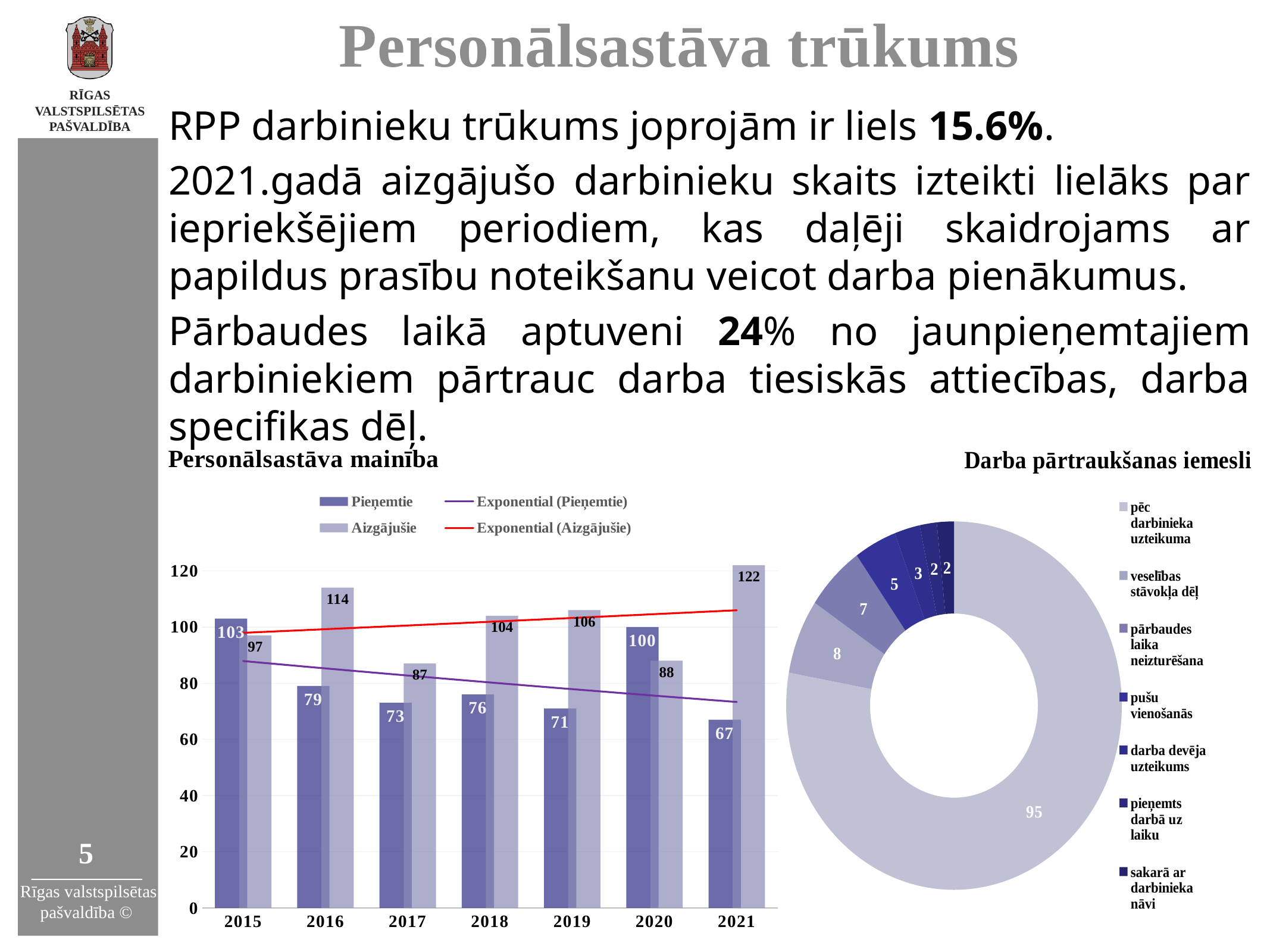
In the 'Personālsastāva mainība' chart, do the Pieņemtie values overall rise or fall from 2015 to 2021? Fall In the 'Personālsastāva mainība' chart, what is the Pieņemtie value for 2015? 103 In the 'Personālsastāva mainība' chart, which year has the highest Aizgājušie value? 2021 In the 'Personālsastāva mainība' chart, which year has the lowest Pieņemtie value? 2021 In the 'Darba pārtraukšanas iemesli' chart, what is the value for 'pēc darbinieka uzteikuma'? 95 In the 'Darba pārtraukšanas iemesli' chart, how many categories does the legend list? 7 How many years are shown on the x axis of the 'Personālsastāva mainība' chart? 7 In the 'Personālsastāva mainība' chart, what is the Aizgājušie value for 2016? 114 What kind of chart is 'Personālsastāva mainība'? Bar chart In the 'Personālsastāva mainība' chart, what is the difference between Aizgājušie and Pieņemtie in 2021? 55 How many entries does the legend of the 'Personālsastāva mainība' chart list? 4 In the 'Personālsastāva mainība' chart, which is larger in 2017: Pieņemtie or Aizgājušie? Aizgājušie